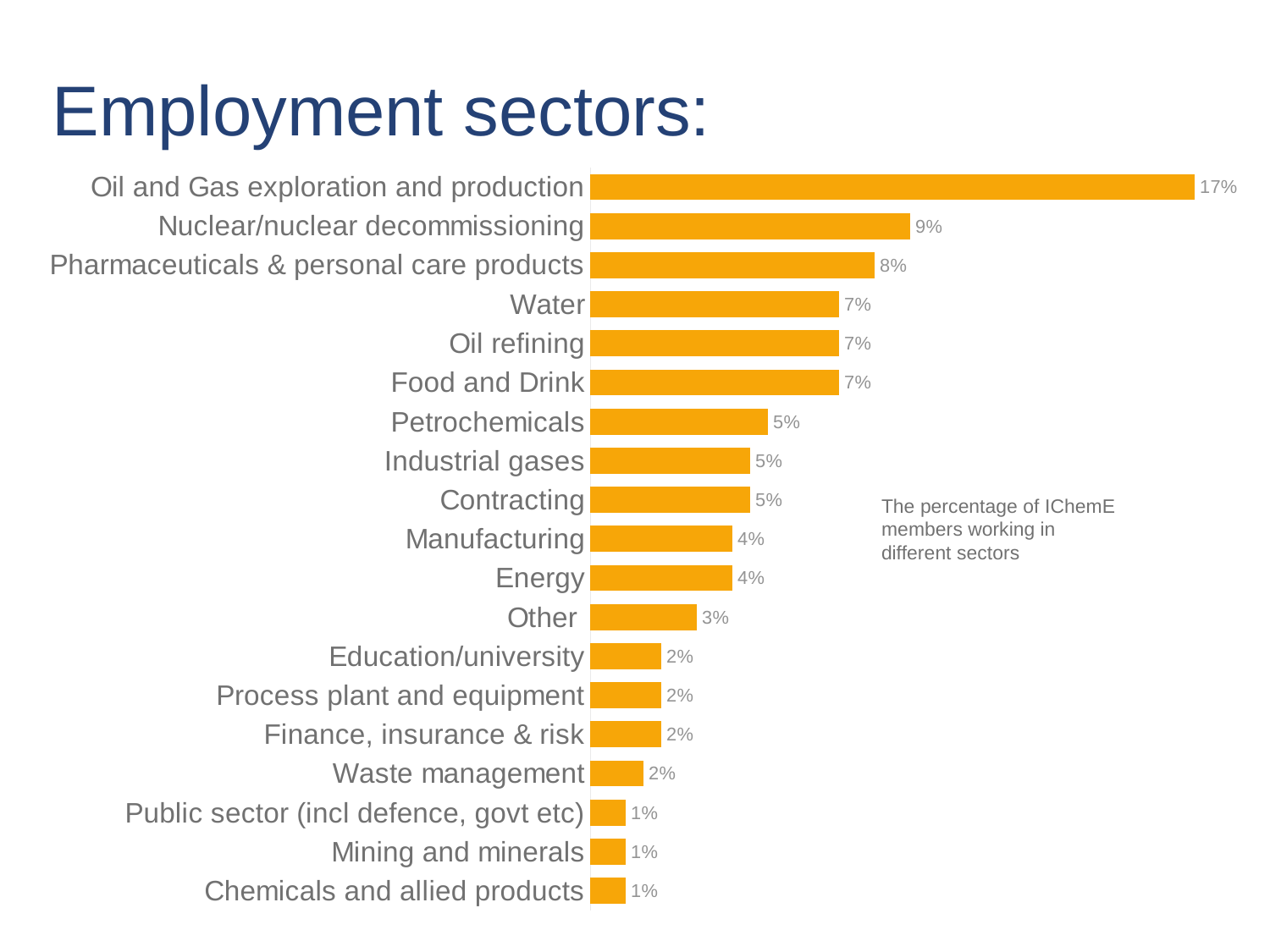
What percentage is shown for Waste management? 2% What is the value for Manufacturing? 4% What type of chart is shown on the slide? Bar chart What percentage is shown for Pharmaceuticals & personal care products? 8% What is the difference between the values for Petrochemicals and Other? 2% Which employment sector has the highest percentage of IChemE members? Oil and Gas exploration and production How many employment sectors are shown in the chart? 19 What is the value shown for Nuclear/nuclear decommissioning? 9% Which has a larger value, Water or Energy? Water What percentage of IChemE members work in Oil and Gas exploration and production? 17% What is the title of the slide? Employment sectors: What is the difference between the percentages for Oil and Gas exploration and production and Nuclear/nuclear decommissioning? 8%